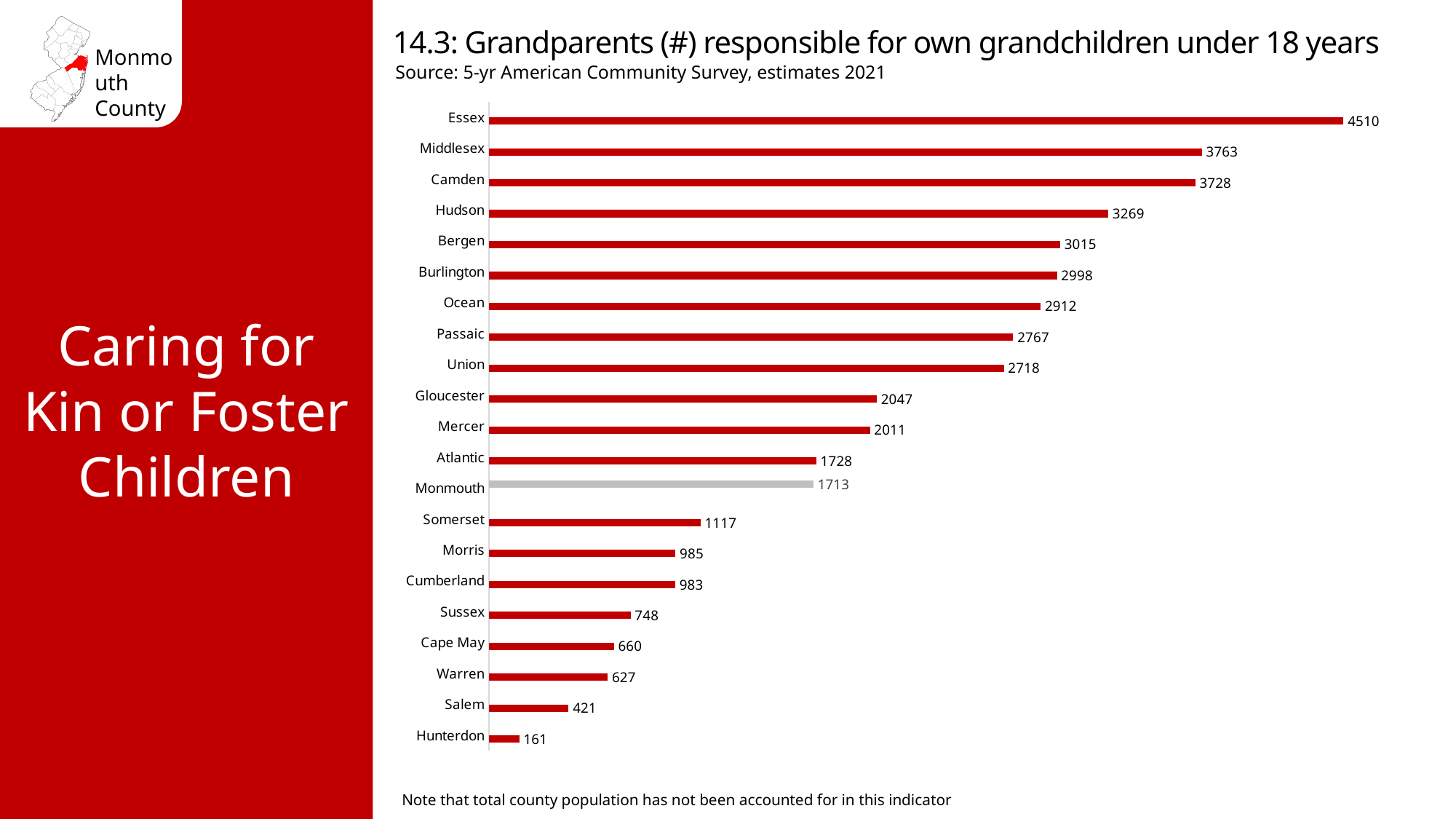
Which county has the highest value? Essex What is the value for Hunterdon? 161 Which is larger, the value for Hudson or the value for Bergen? Hudson Which county's bar is shown in grey rather than red? Monmouth What is the difference between the values for Atlantic and Monmouth? 15 What is the value for Essex? 4510 What is the difference between the values for Essex and Middlesex? 747 Which is larger, the value for Somerset or the value for Sussex? Somerset What kind of chart is shown on the slide? Bar chart How many counties are shown in the chart? 21 Which county has the lowest value? Hunterdon What is the value for Monmouth? 1713